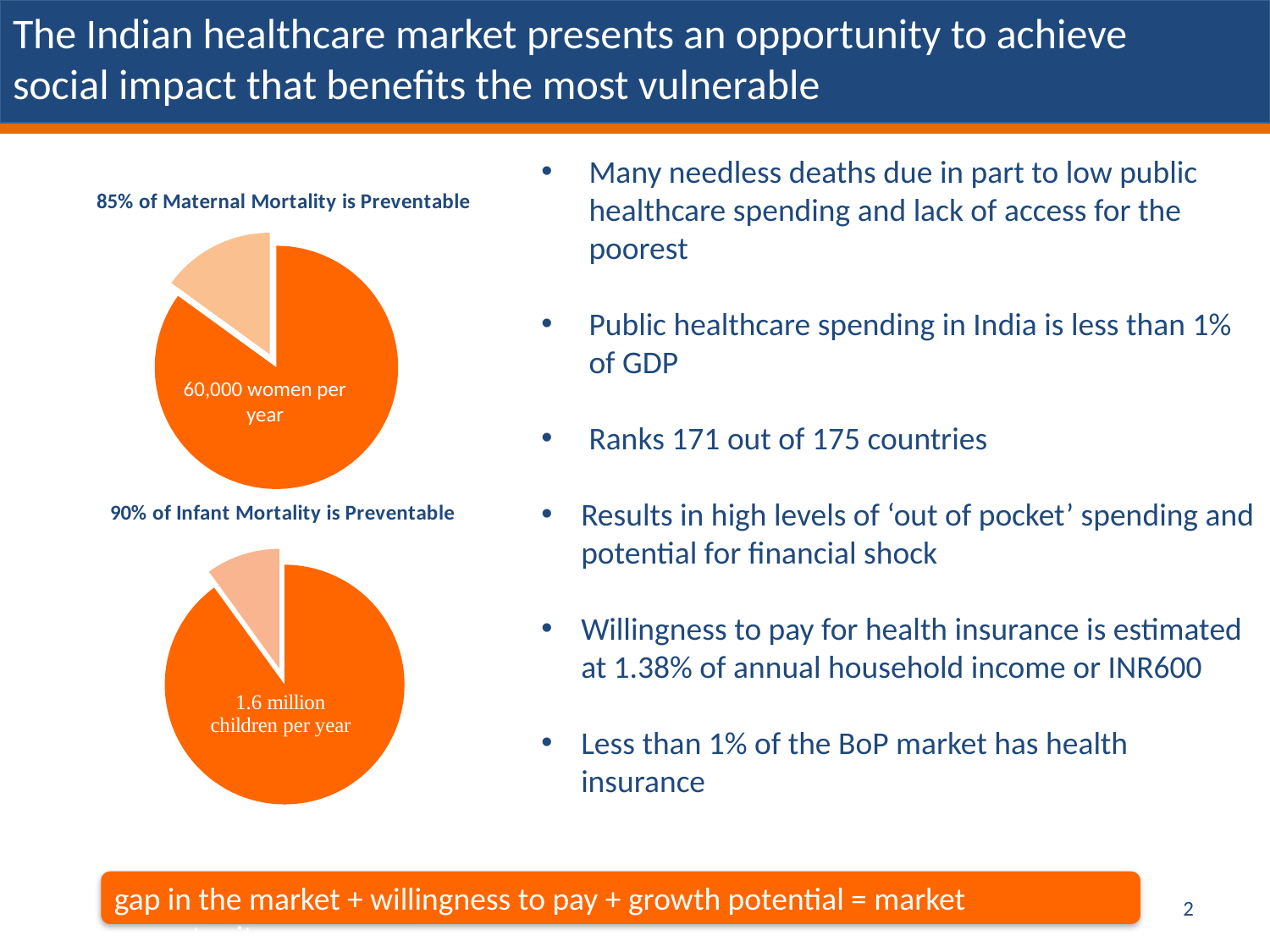
What is the title of the bottom pie chart? 90% of Infant Mortality is Preventable What label is printed inside the large slice of the bottom pie chart (infant mortality)? 1.6 million children per year In the top pie chart (maternal mortality), which slice is larger, the dark orange slice or the light orange slice? The dark orange slice What kind of chart is the top chart titled "85% of Maternal Mortality is Preventable"? Pie chart How many slices does the top pie chart (maternal mortality) have? 2 According to the bottom chart's title, what share of infant mortality is preventable? 90% What kind of chart is the bottom chart titled "90% of Infant Mortality is Preventable"? Pie chart What is the title of the top pie chart? 85% of Maternal Mortality is Preventable In the bottom pie chart (infant mortality), which slice is larger, the dark orange slice or the light orange slice? The dark orange slice According to the top chart's title, what share of maternal mortality is preventable? 85% How many slices does the bottom pie chart (infant mortality) have? 2 What label is printed inside the large slice of the top pie chart (maternal mortality)? 60,000 women per year